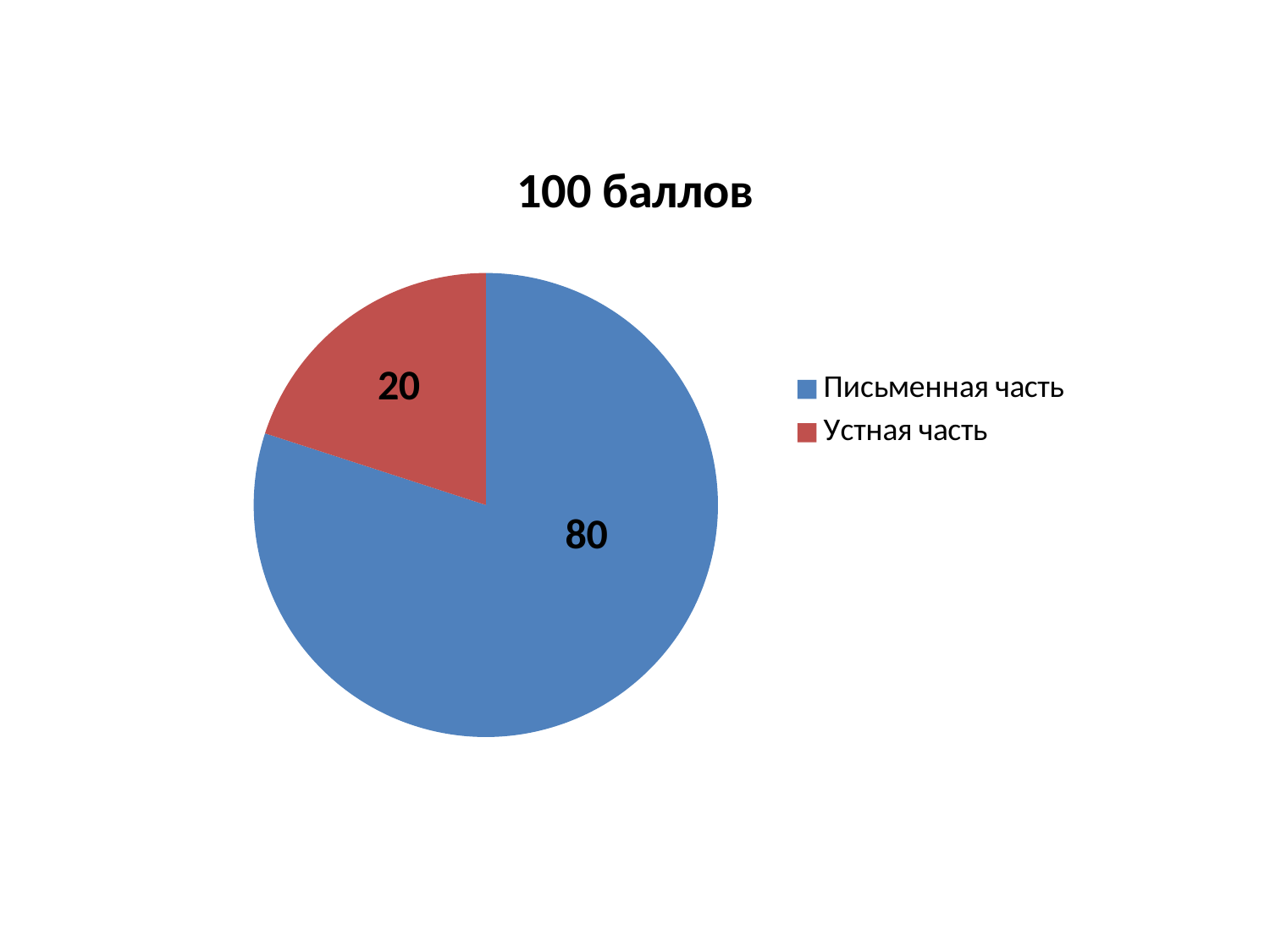
Which category has the smallest slice? Устная часть How many entries does the legend list? 2 What is the difference between the values for Письменная часть and Устная часть? 60 How many slices does the pie chart have? 2 What is the title of the chart? 100 баллов Which category has the largest slice? Письменная часть What type of chart is shown on the slide? pie chart What colour is the slice for Устная часть? red What is the value for Устная часть? 20 What share of the pie does Устная часть represent? 20% Which is larger, Письменная часть or Устная часть? Письменная часть What is the value for Письменная часть? 80